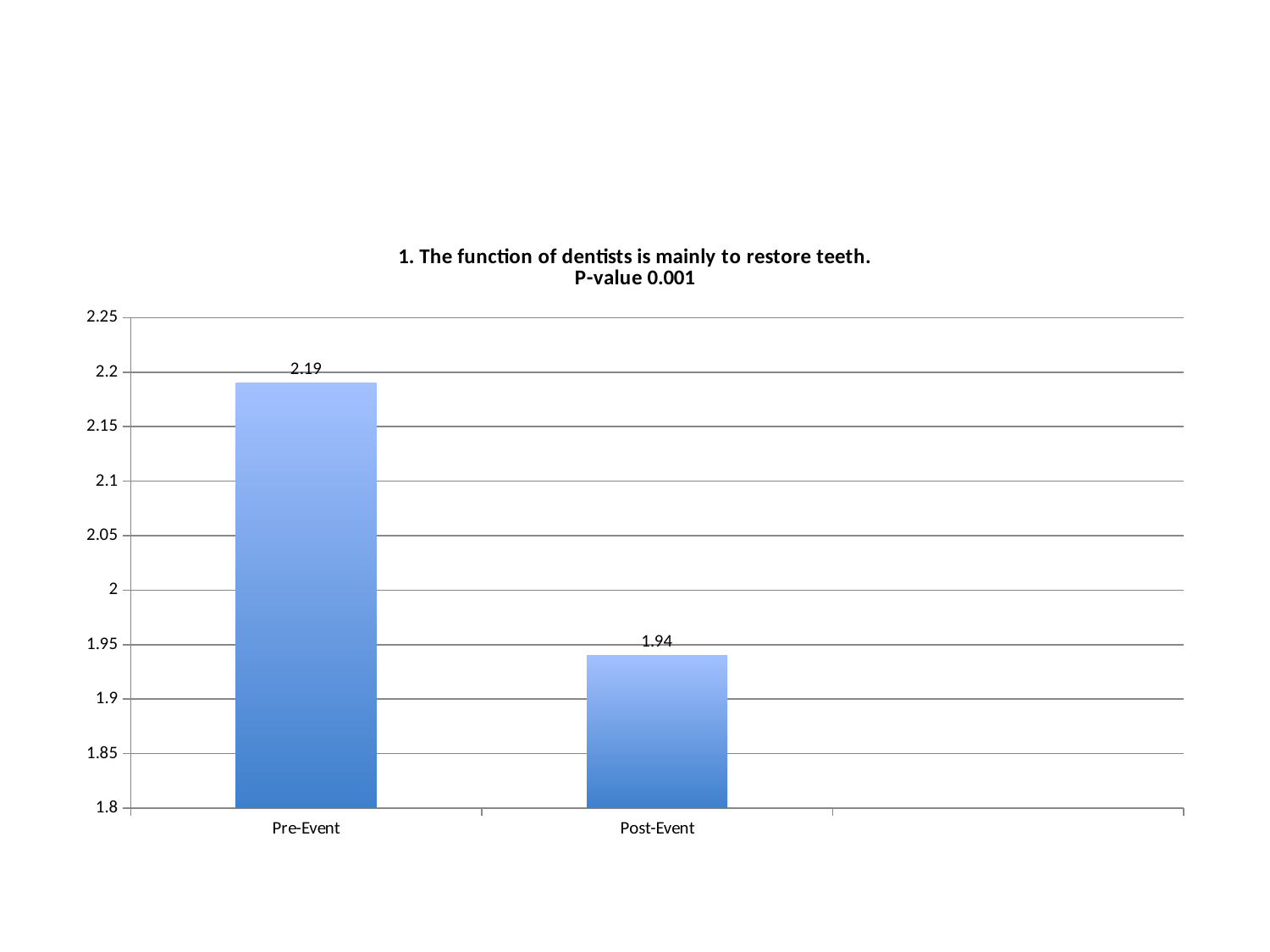
Is the value for Pre-Event greater or less than 2.1? greater Which is larger, the Pre-Event value or the Post-Event value? Pre-Event What is the value for Pre-Event? 2.19 How many categories are shown on the x axis? 2 What is the value for Post-Event? 1.94 What P-value is stated in the chart title? 0.001 Which category has the lowest value? Post-Event Is the value for Post-Event greater or less than 2? less Which category has the highest value? Pre-Event What kind of chart is shown on the slide? bar chart What is the difference between the Pre-Event and Post-Event values? 0.25 Do the values rise or fall from Pre-Event to Post-Event? fall